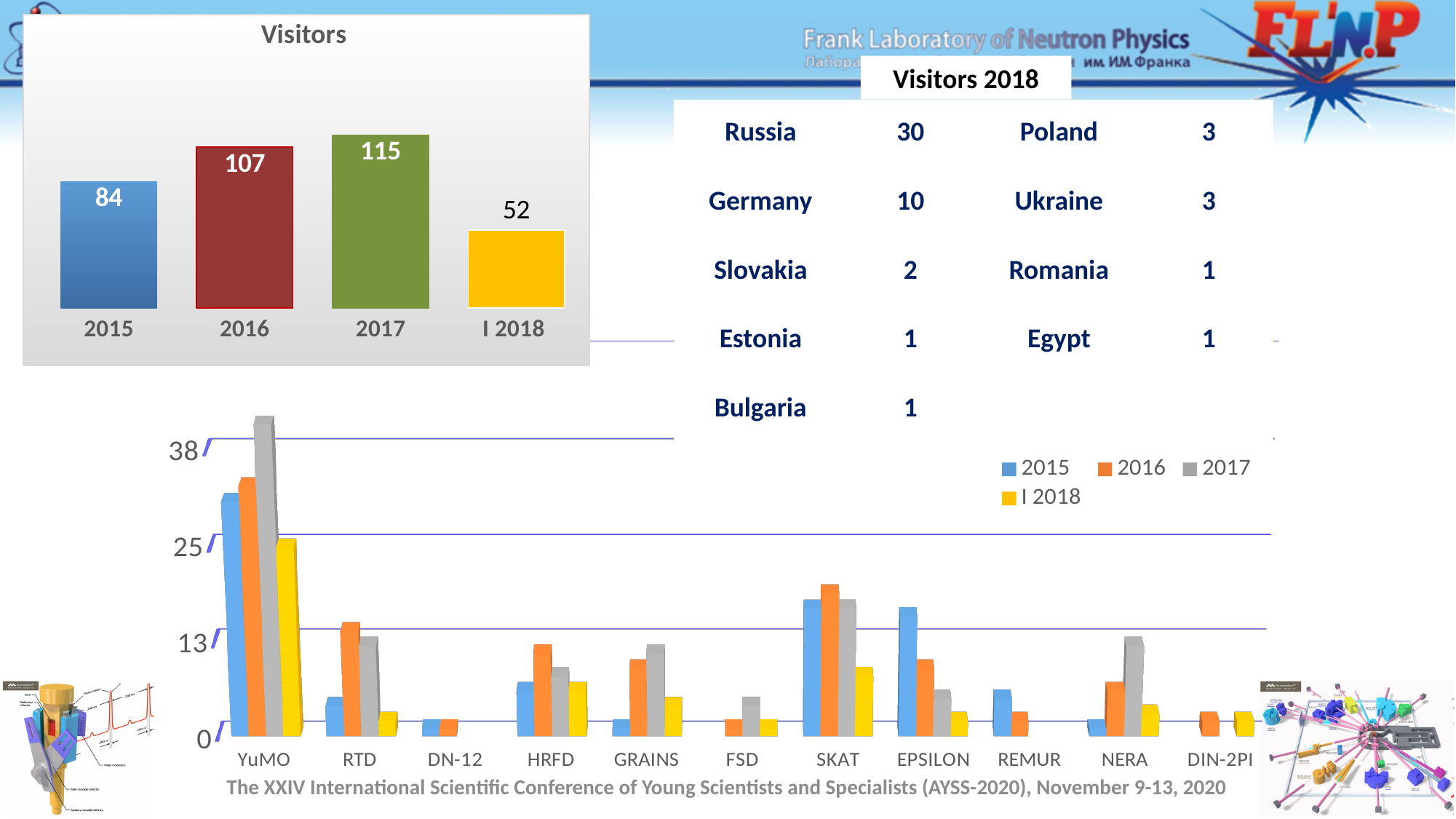
In the 'Visitors' chart, which year has the highest value? 2017 What kind of chart is the 'Visitors' chart at the top left? bar chart In the bottom chart, is the 2017 value for YuMO greater or less than 38? greater In the bottom chart, is the 2015 value for SKAT greater or less than 13? greater In the bottom chart, which instrument has the highest 2015 value? YuMO In the 'Visitors' chart, what is the value for I 2018? 52 In the 'Visitors' chart, how many categories are shown on the x axis? 4 In the 'Visitors' chart, which category has the lowest value? I 2018 In the bottom chart, how many instrument categories are shown on the x axis? 11 In the 'Visitors' chart, what is the difference between the values for 2016 and 2015? 23 In the 'Visitors' chart, what is the value for 2017? 115 In the bottom chart, how many series does the legend list? 4